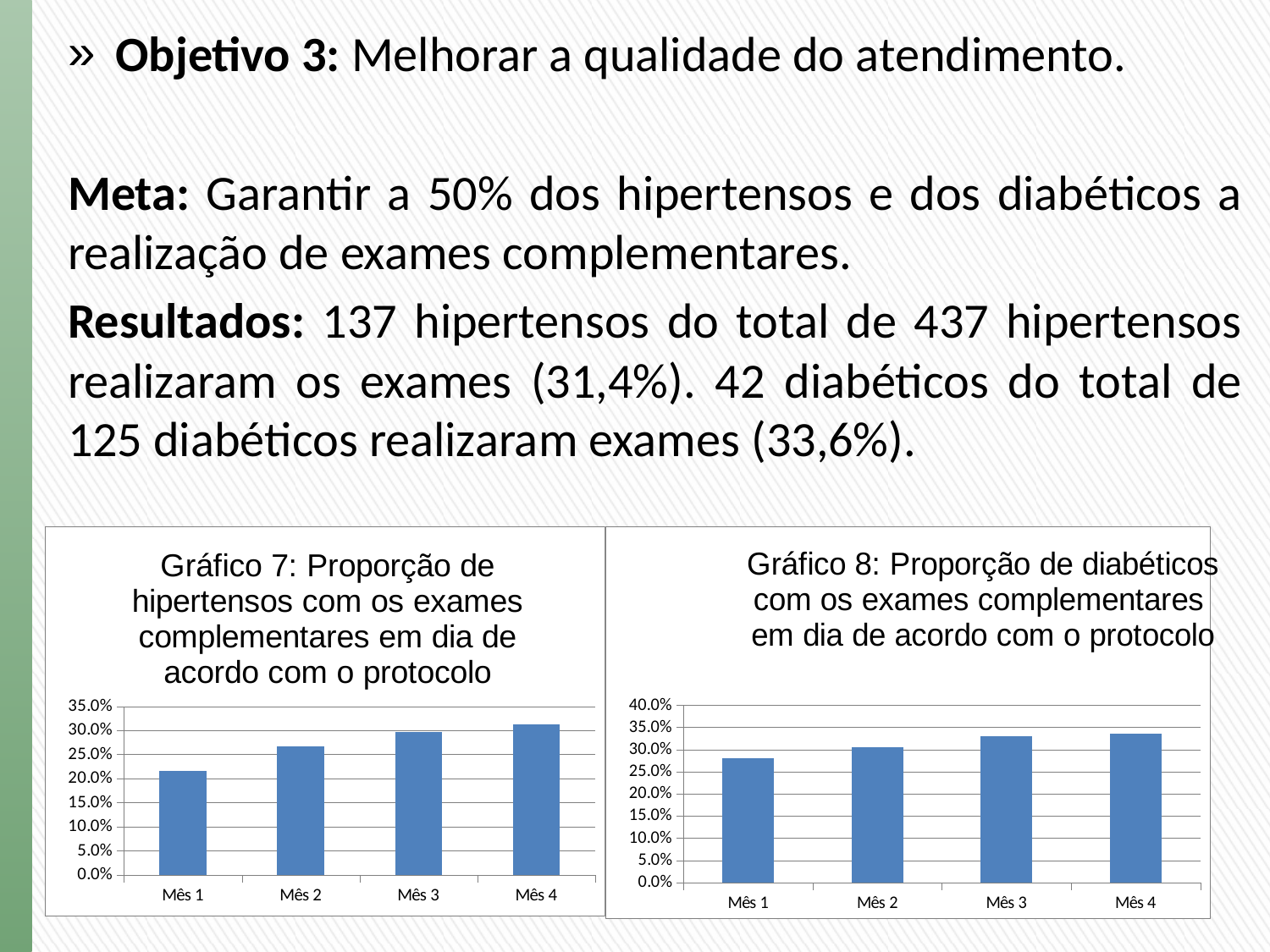
In Gráfico 7, how many months are shown on the x axis? 4 In Gráfico 7, is the value for Mês 4 greater or less than 30.0%? greater In Gráfico 7, do the values rise or fall from Mês 1 to Mês 4? rise In Gráfico 7, which month has the lowest proportion? Mês 1 In Gráfico 8, do the values rise or fall from Mês 1 to Mês 4? rise In Gráfico 7, which month has the highest proportion? Mês 4 In Gráfico 8, is the value for Mês 1 greater or less than 30.0%? less In Gráfico 7, is the value for Mês 1 greater or less than 25.0%? less What type of chart is Gráfico 7? bar chart In Gráfico 8, which is larger, the value for Mês 2 or the value for Mês 1? Mês 2 In Gráfico 8, which month has the lowest proportion? Mês 1